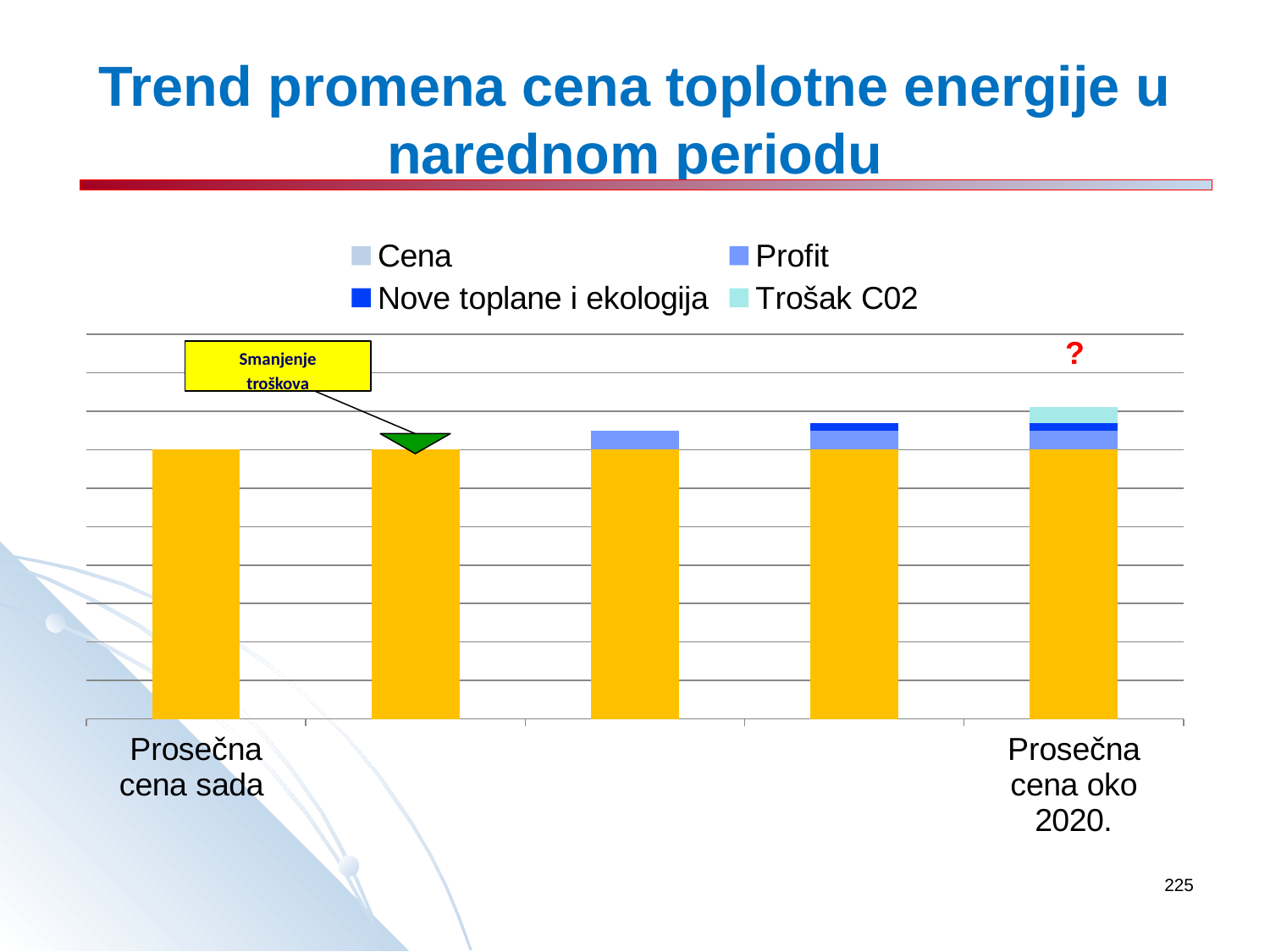
Do the total bar heights generally rise or fall from left to right across the chart? rise Which legend series appears only in the rightmost bar? Trošak C02 Is the total stacked bar for "Prosečna cena oko 2020." larger or smaller than the bar for "Prosečna cena sada"? larger How many bars are plotted in the chart? 5 How many series does the legend list? 4 What kind of chart is shown on the slide? Stacked bar chart Which series is shown in the bottom (yellow) segment of every bar? Cena Which category has the tallest stacked bar? Prosečna cena oko 2020.